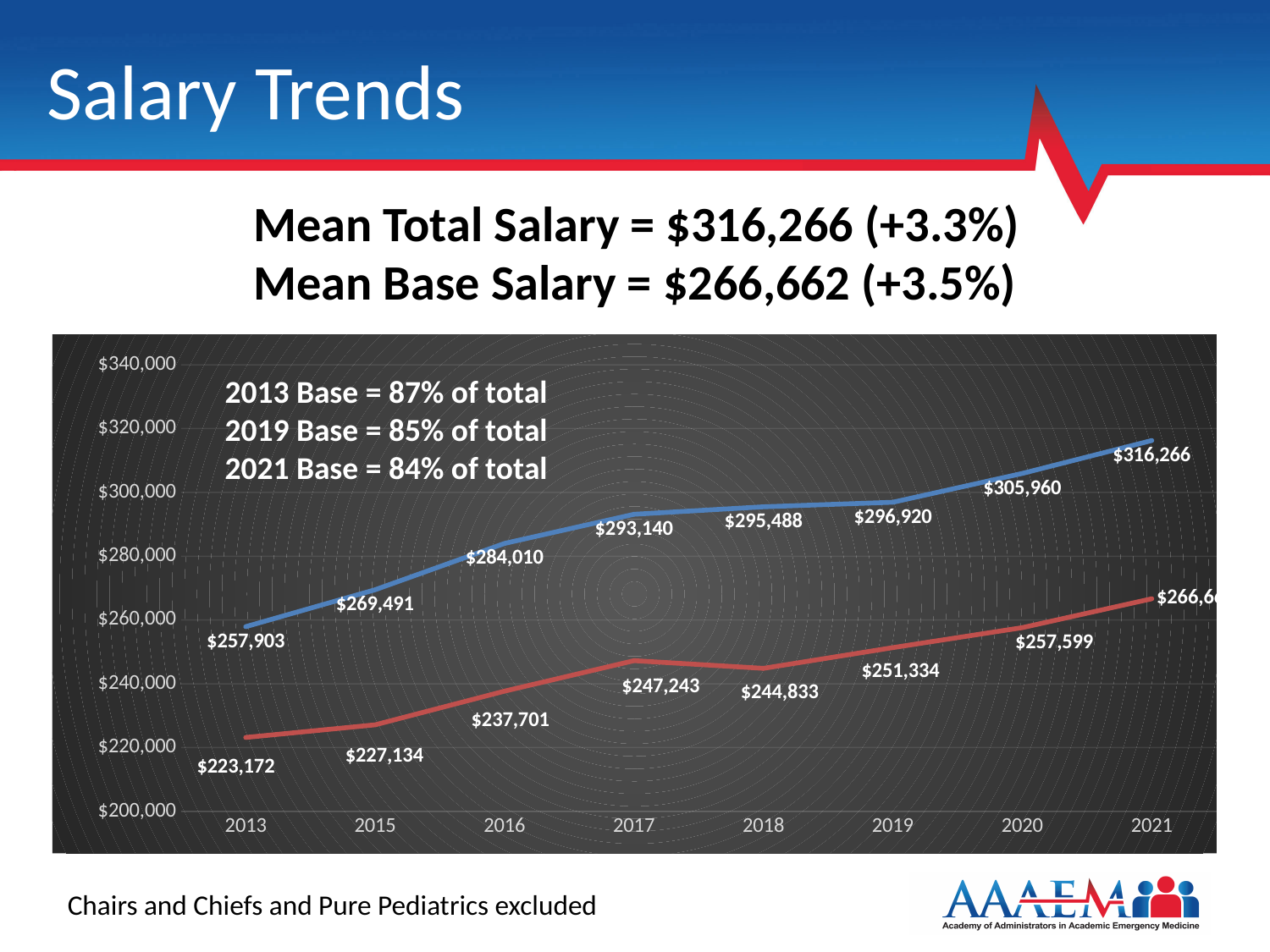
What is the mean total salary (blue line) shown for 2016? $284,010 What is the mean total salary (blue line) shown for 2013? $257,903 Which is larger, the mean base salary in 2017 or in 2018? 2017 What is the mean base salary (red line) shown for 2019? $251,334 In which year is the mean total salary (blue line) highest? 2021 In which year is the mean base salary (red line) lowest? 2013 How many years are plotted along the x axis of the chart? 8 By how much did the mean total salary (blue line) increase from 2019 to 2020? $9,040 What is the difference between the mean total salary and the mean base salary in 2013? $34,731 Does the mean total salary (blue line) generally rise or fall from 2013 to 2021? Rise What kind of chart is shown on the slide? Line chart According to the text on the chart, what percentage of total salary was the base salary in 2021? 84%